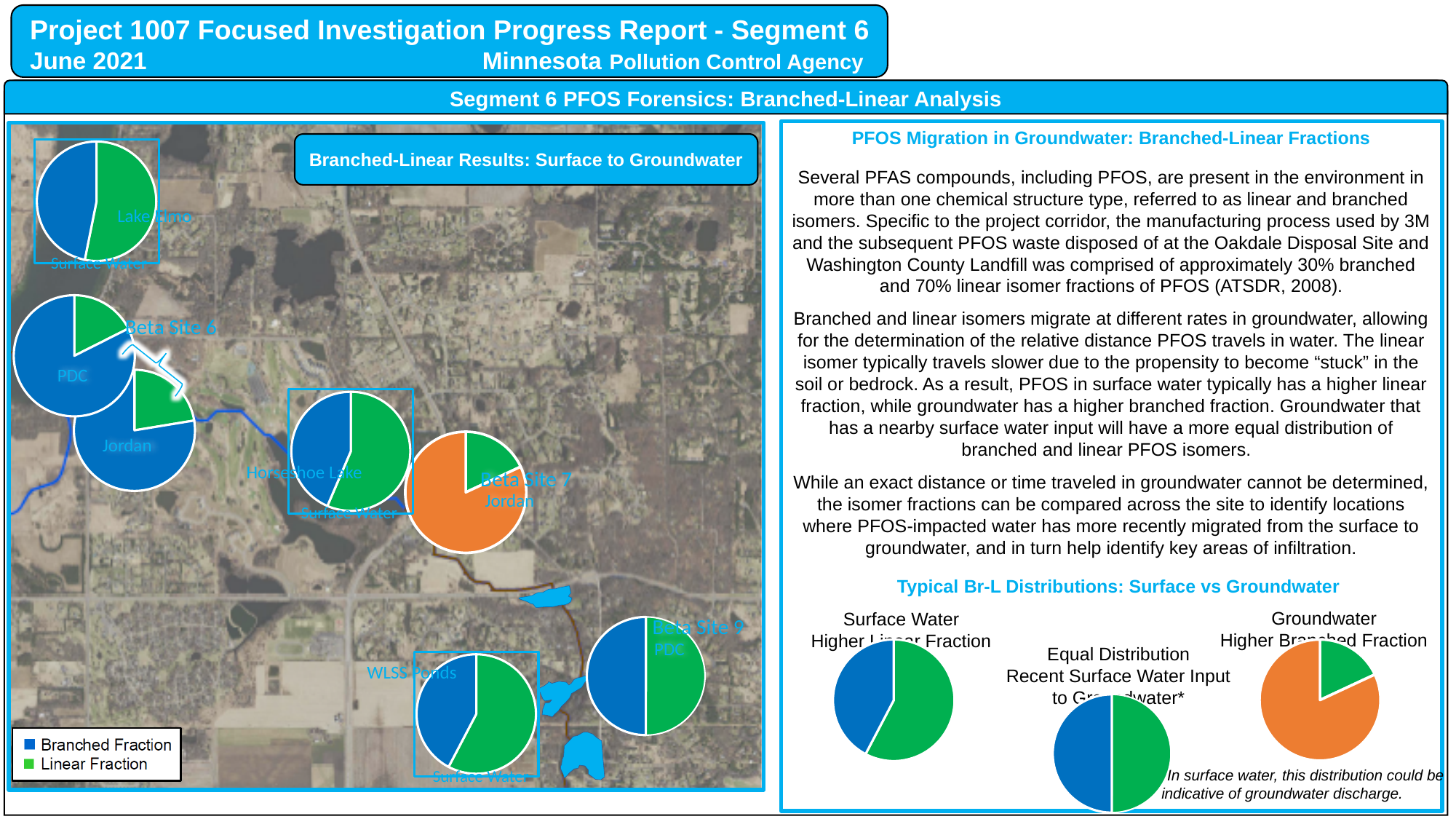
In the Jordan pie chart at Beta Site 6, which fraction is larger, branched or linear? Branched Which colour represents the Branched Fraction in the map legend? Blue In the 'Surface Water Higher Linear Fraction' pie chart on the right, which fraction is larger? Linear What are the two entries in the map legend? Branched Fraction and Linear Fraction In the PDC pie chart at Beta Site 6, which fraction is larger, branched or linear? Branched How many pie charts are plotted on the map? 7 How many entries does the legend in the lower-left corner of the map list? 2 What is the title of the chart box on the map? Branched-Linear Results: Surface to Groundwater What kind of chart is used to show the branched-linear results on the map? Pie chart